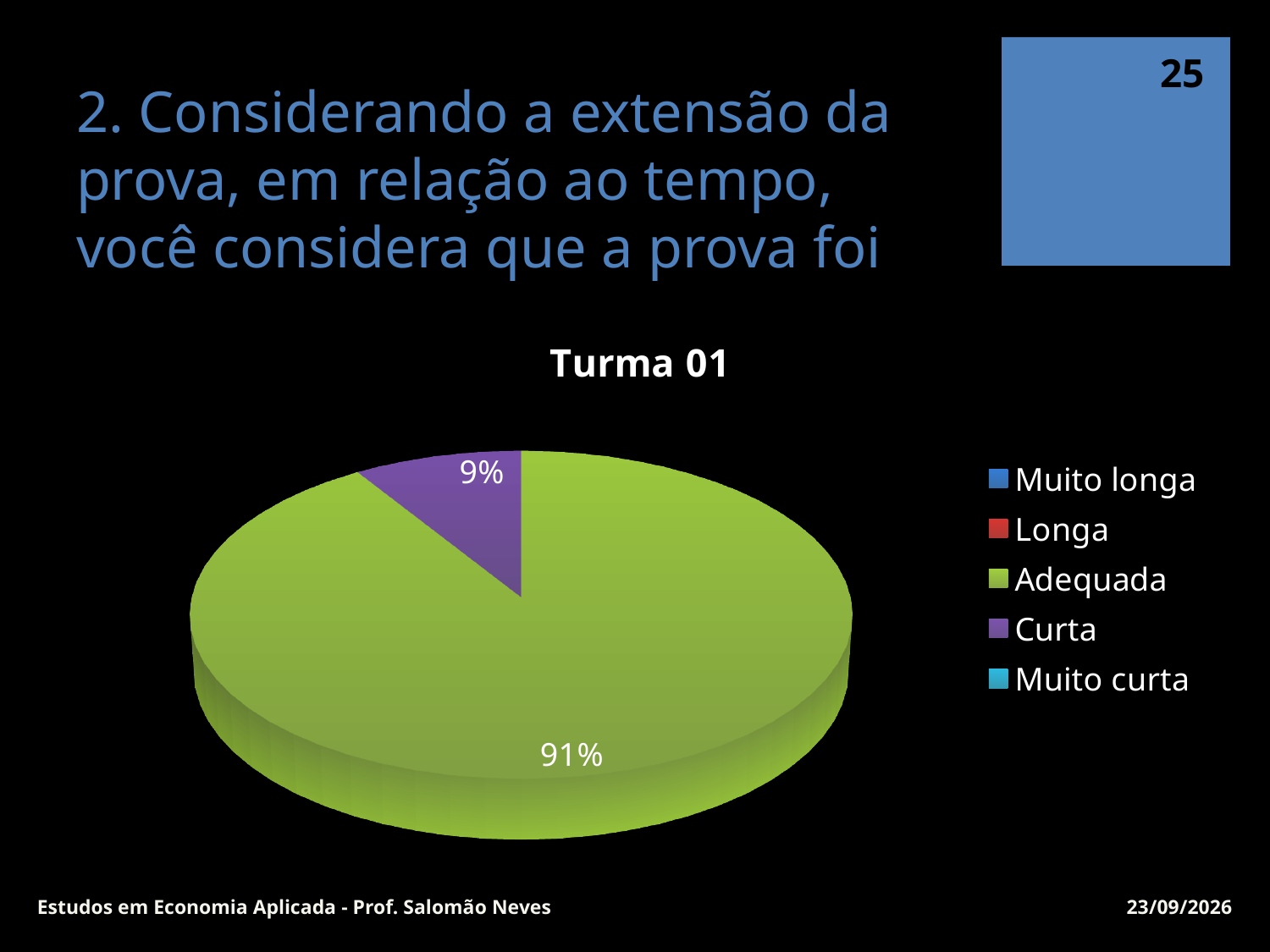
What is the title of the chart? Turma 01 What colour is the Adequada slice? green How many entries does the legend list? 5 Which of the two visible slices is larger, Adequada or Curta? Adequada What share of the pie does Curta have? 9% Which category has the largest slice of the pie? Adequada How many slices are visible in the pie? 2 What is the difference in percentage points between the Adequada and Curta slices? 82 What share of the pie does Adequada have? 91% What kind of chart is shown on the slide? pie chart